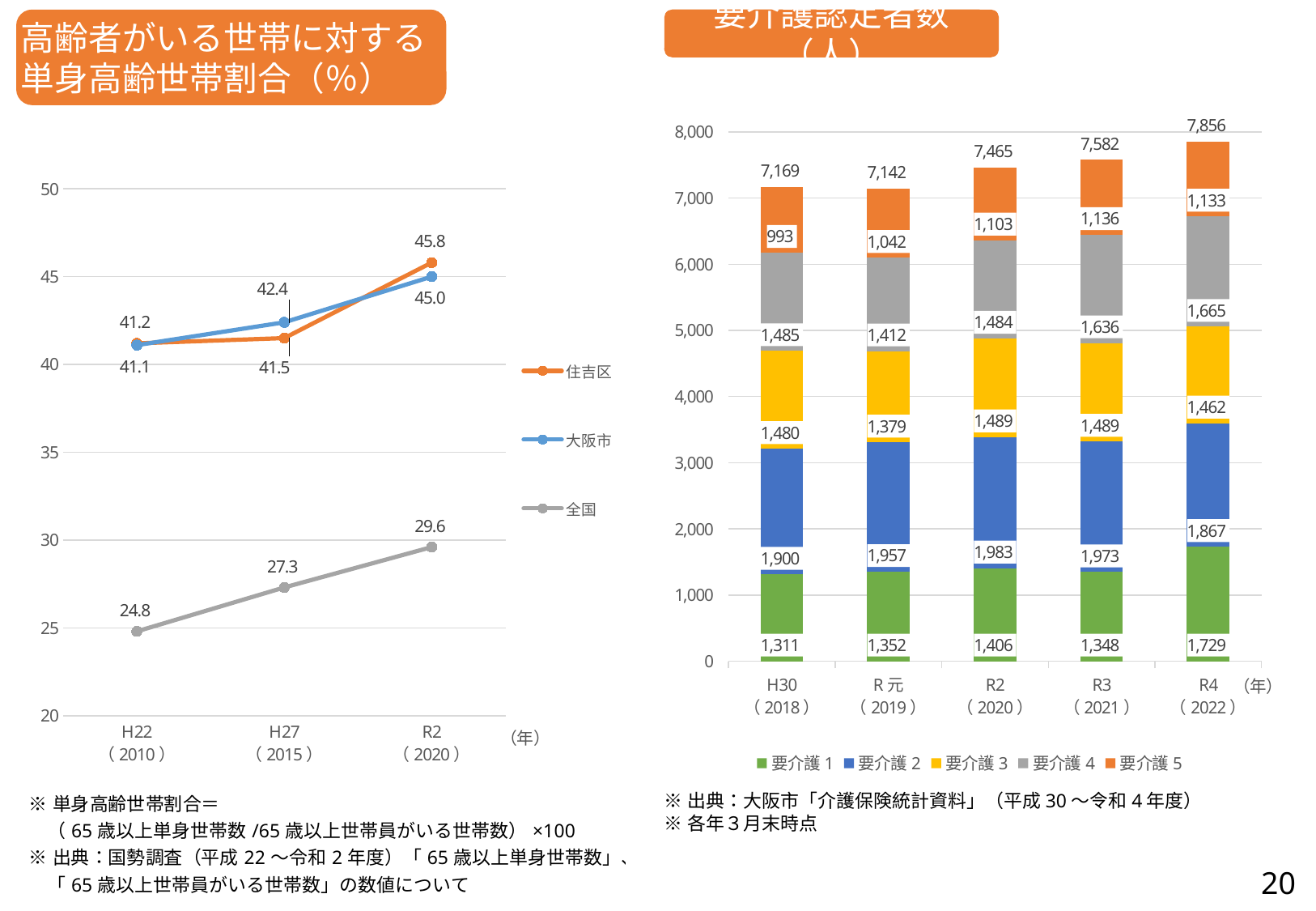
In the chart titled 要介護認定者数（人）, what is the value of 要介護 1 in R2（2020）? 1,406 In the chart titled 高齢者がいる世帯に対する単身高齢世帯割合（%）, what is the value for 住吉区 in R2（2020）? 45.8 What kind of chart is the chart titled 高齢者がいる世帯に対する単身高齢世帯割合（%）? line chart In the chart titled 高齢者がいる世帯に対する単身高齢世帯割合（%）, does the 全国 line rise or fall from H22（2010）to R2（2020）? rise What kind of chart is the chart titled 要介護認定者数（人）? stacked bar chart In the chart titled 要介護認定者数（人）, how many series does the legend list? 5 In the chart titled 要介護認定者数（人）, which year has the lowest total? R 元（2019） In the chart titled 高齢者がいる世帯に対する単身高齢世帯割合（%）, what is the value for 全国 in R2（2020）? 29.6 In the chart titled 要介護認定者数（人）, what is the value of 要介護 5 in H30（2018）? 993 In the chart titled 要介護認定者数（人）, which year has the highest total? R4（2022） In the chart titled 要介護認定者数（人）, what is the total for R4（2022）? 7,856 In the chart titled 要介護認定者数（人）, what is the difference between the totals for R4（2022）and H30（2018）? 687